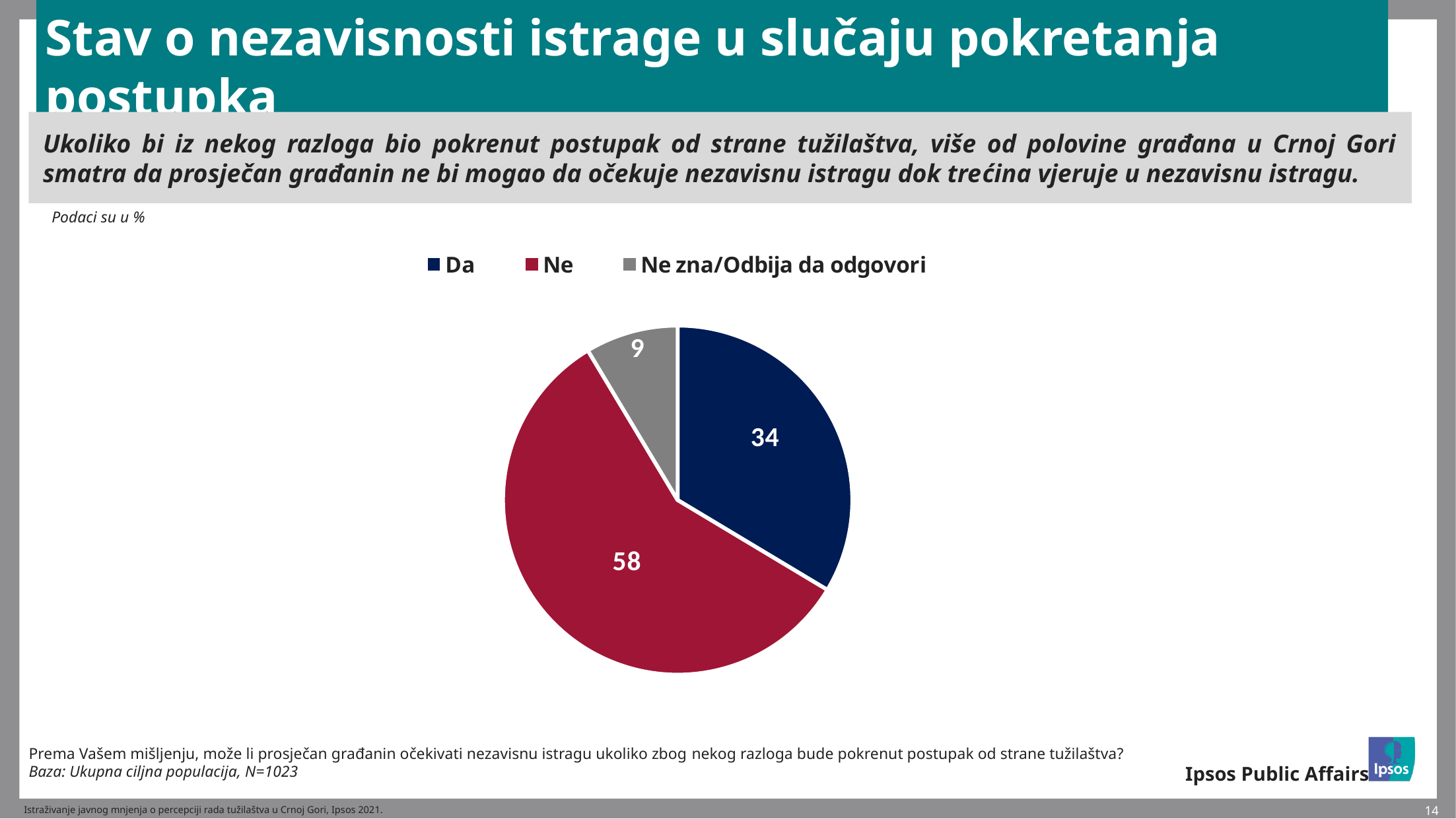
Which category has the smallest slice? Ne zna/Odbija da odgovori Which is larger, the value for "Da" or the value for "Ne zna/Odbija da odgovori"? Da What kind of chart is shown on the slide? pie chart What is the value for "Ne"? 58 How many entries does the legend list? 3 What is the difference between the values for "Ne" and "Da"? 24 What colour is the slice for "Ne"? red Which category has the largest slice? Ne How many slices does the pie chart have? 3 What is the value for "Ne zna/Odbija da odgovori"? 9 What is the value for "Da"? 34 What unit are the data in, according to the note above the chart? %